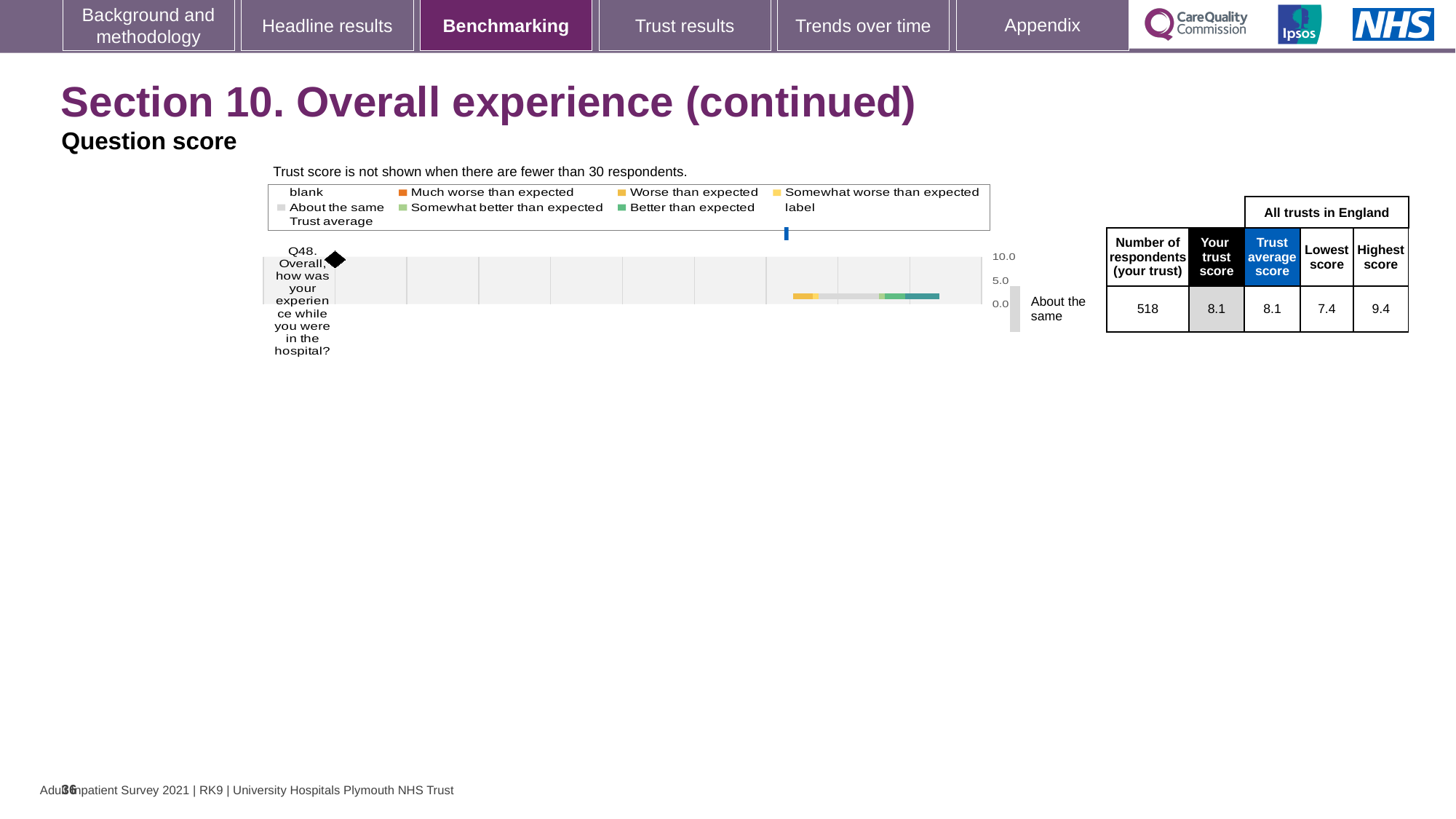
How many survey questions are plotted in the chart? 1 Is the trust's score for Q48 greater or less than 5.0 on the chart axis? greater How many respondents from the trust answered Q48? 518 What is the lowest score among all trusts in England for Q48? 7.4 Which benchmarking category is the trust's Q48 score placed in? About the same By how much does the trust's score for Q48 exceed the lowest score in England? 0.7 What is the trust's score for Q48? 8.1 Which survey question is plotted in the benchmarking chart? Q48. Overall, how was your experience while you were in the hospital? What is the difference between the highest and lowest scores for Q48 across all trusts in England? 2.0 What is the highest score among all trusts in England for Q48? 9.4 What type of chart is used to show the Q48 benchmarking result? Bar chart What is the trust average score across all trusts in England for Q48? 8.1